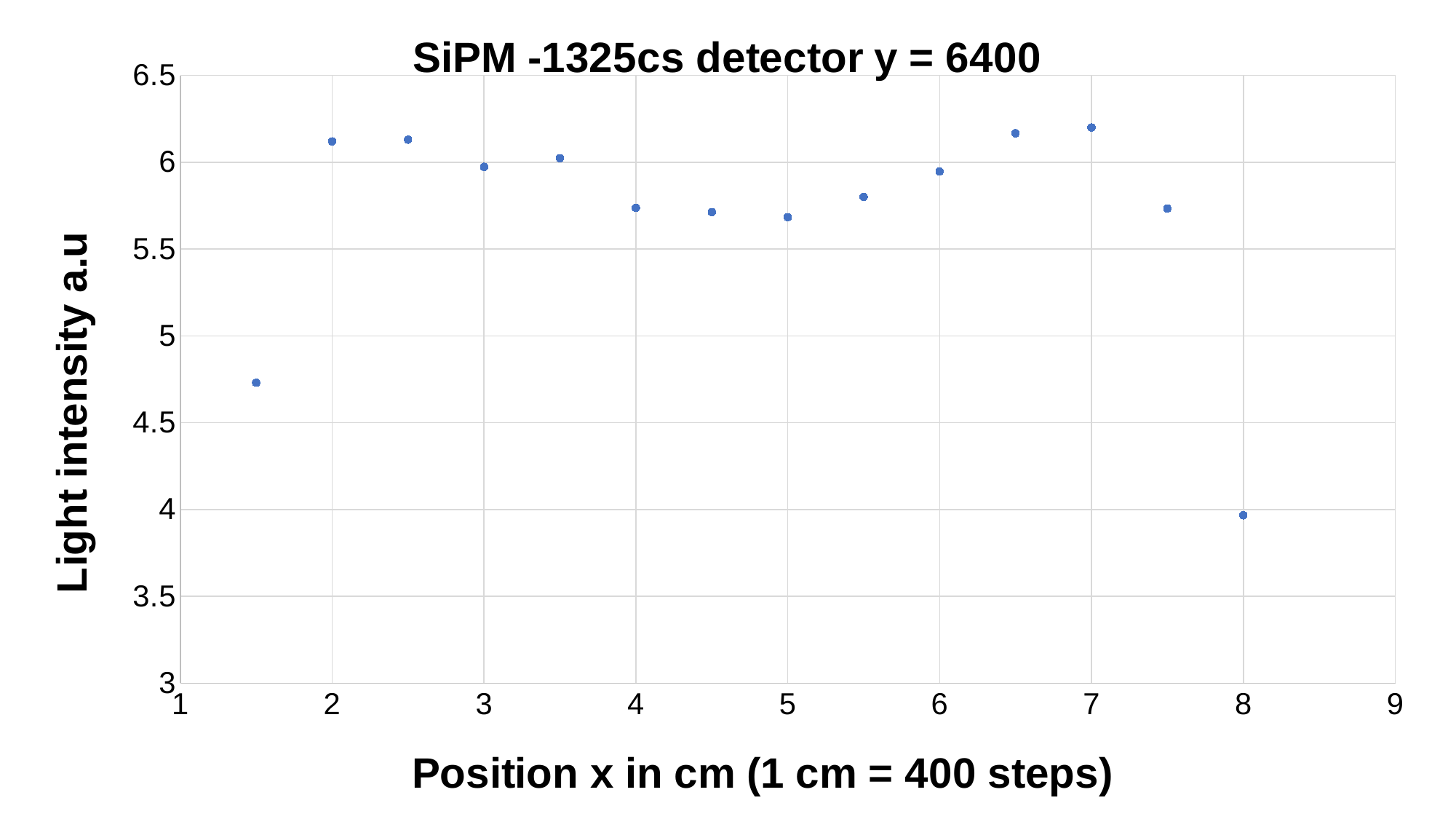
Which has the higher light intensity, position x = 1.5 or position x = 8? x = 1.5 Is the light intensity at position x = 4 greater or less than 6? less Is the light intensity at position x = 2 greater or less than 6? greater Which has the higher light intensity, position x = 7 or position x = 7.5? x = 7 Is the light intensity at position x = 5 greater or less than 5.5? greater What kind of chart is shown on the slide? Scatter chart What is the label of the y axis? Light intensity a.u How many data points are plotted on the chart? 14 What is the title of the chart? SiPM -1325cs detector y = 6400 At which x position is the light intensity lowest? 8